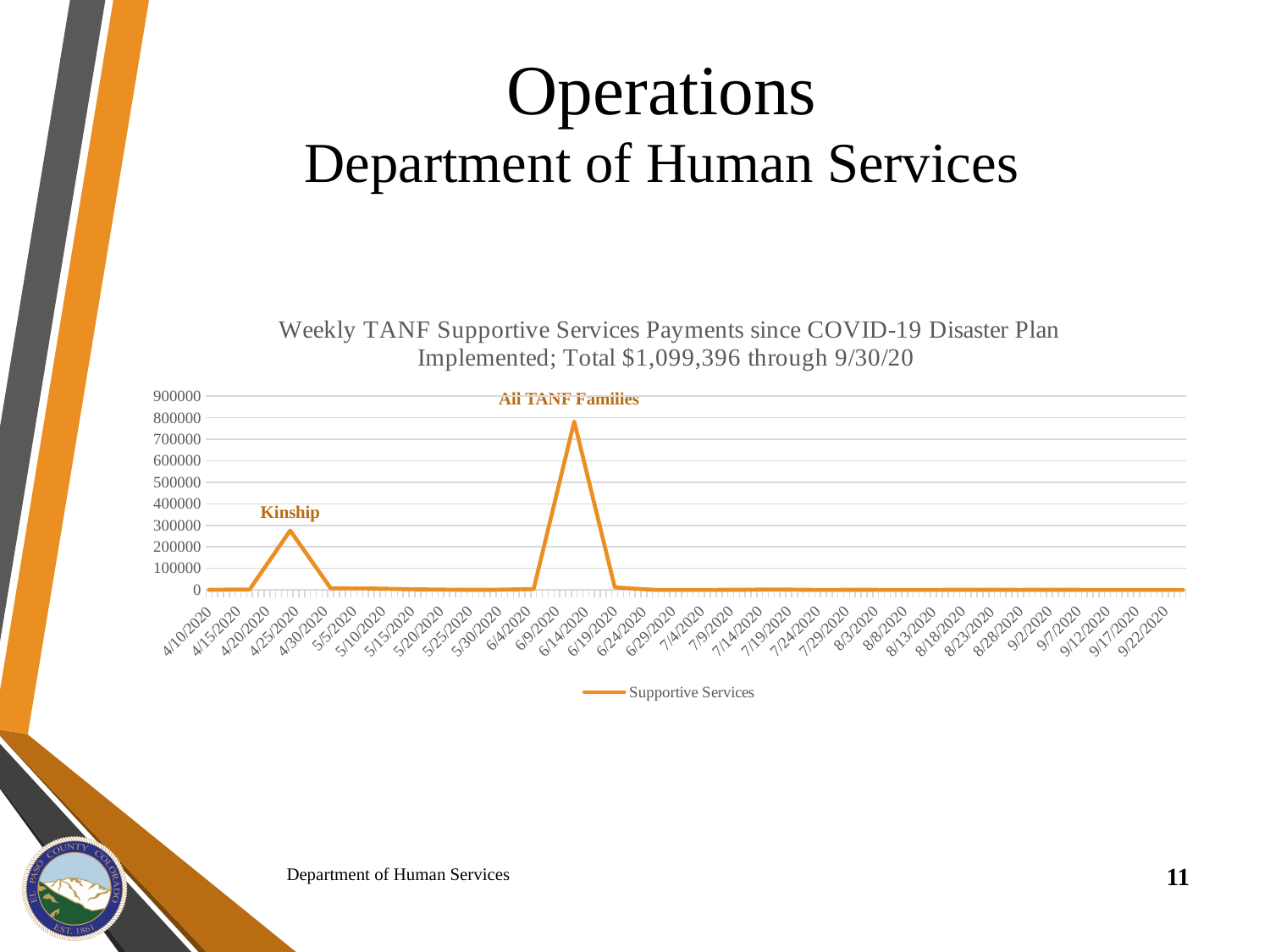
Is the value for Kinship larger or smaller than the value for All TANF Families? smaller What kind of chart is shown on the slide? line chart Which labelled peak in the chart is lower, Kinship or All TANF Families? Kinship Is the value at the All TANF Families peak greater or less than 900000? less Is the value at the All TANF Families peak greater or less than 700000? greater Is the value at the Kinship peak greater or less than 200000? greater What is the name of the series shown in the chart's legend? Supportive Services According to the chart title, what is the total of TANF Supportive Services payments through 9/30/20? $1,099,396 How many series does the chart's legend list? 1 Which labelled peak in the chart is higher, Kinship or All TANF Families? All TANF Families